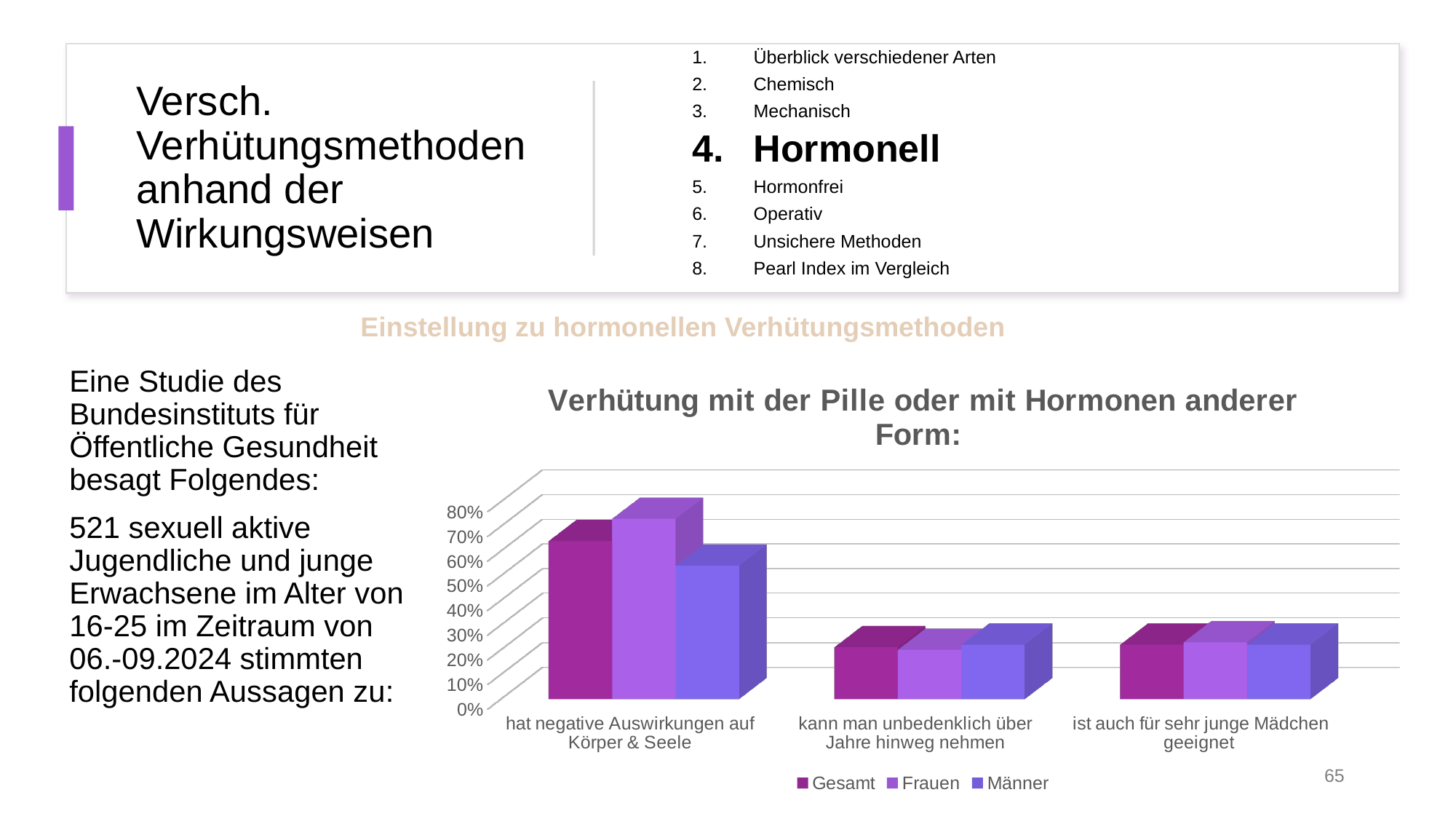
Is the Gesamt value for "kann man unbedenklich über Jahre hinweg nehmen" greater or less than 40%? less Is the Gesamt value for "hat negative Auswirkungen auf Körper & Seele" greater or less than 50%? greater What are the series names listed in the chart legend? Gesamt, Frauen, Männer How many categories are shown on the x axis of the chart? 3 For the Gesamt series, which is larger: the value for "hat negative Auswirkungen auf Körper & Seele" or for "kann man unbedenklich über Jahre hinweg nehmen"? hat negative Auswirkungen auf Körper & Seele Is the Frauen value for "hat negative Auswirkungen auf Körper & Seele" greater or less than 60%? greater What is the title of the chart? Verhütung mit der Pille oder mit Hormonen anderer Form: For "hat negative Auswirkungen auf Körper & Seele", which is larger: the Frauen value or the Männer value? Frauen How many series does the chart legend list? 3 Which category has the highest values across all series? hat negative Auswirkungen auf Körper & Seele What kind of chart is shown on the slide? bar chart